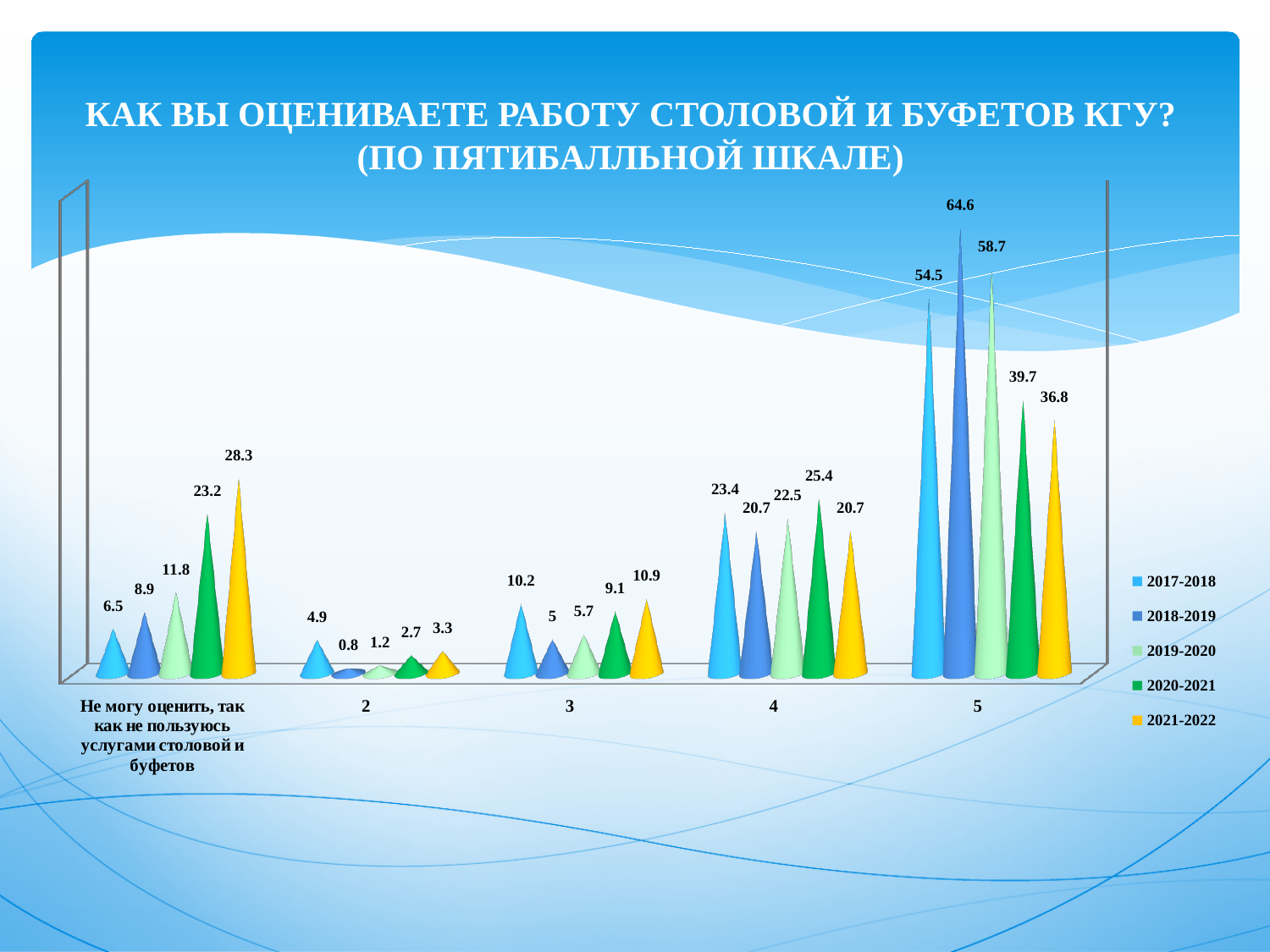
How many series does the legend list? 5 Which is larger in category 4: the value for 2017-2018 or the value for 2019-2020? 2017-2018 Which colour represents the 2021-2022 series in the legend? Yellow Do the values for 2020-2021 rise or fall from category 2 to category 5? Rise What kind of chart is shown on the slide? Bar chart What is the value for 2019-2020 in category 3? 5.7 How many categories are shown on the x axis? 5 What is the value for 2018-2019 in category 5? 64.6 What is the difference between the 2018-2019 and 2021-2022 values in category 5? 27.8 Which series has the highest value in category 5? 2018-2019 What is the value for 2021-2022 in the category "Не могу оценить, так как не пользуюсь услугами столовой и буфетов"? 28.3 Which series has the lowest value in category 2? 2018-2019